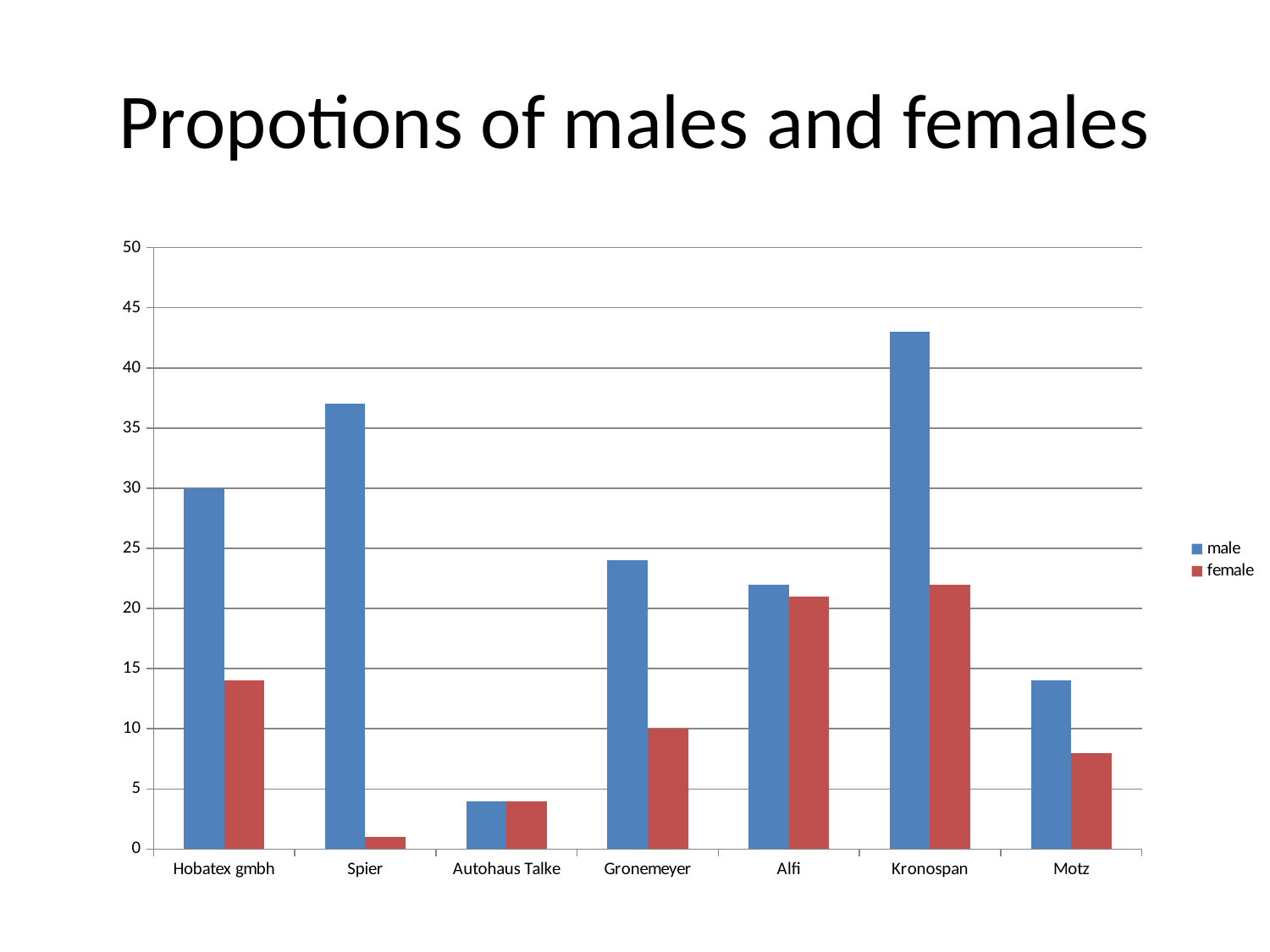
What is the title of the chart? Propotions of males and females Which company has the lowest female value? Spier What is the female value for Gronemeyer? 10 What is the male value for Hobatex gmbh? 30 Is the female value for Spier greater or less than 5? less Which company has the highest male value? Kronospan Is the male value for Kronospan greater or less than 40? greater Which is larger, the male value for Spier or the male value for Hobatex gmbh? Spier What type of chart is shown on the slide? bar chart How many companies are shown along the x axis? 7 How many series does the legend list? 2 Which company has the lowest male value? Autohaus Talke